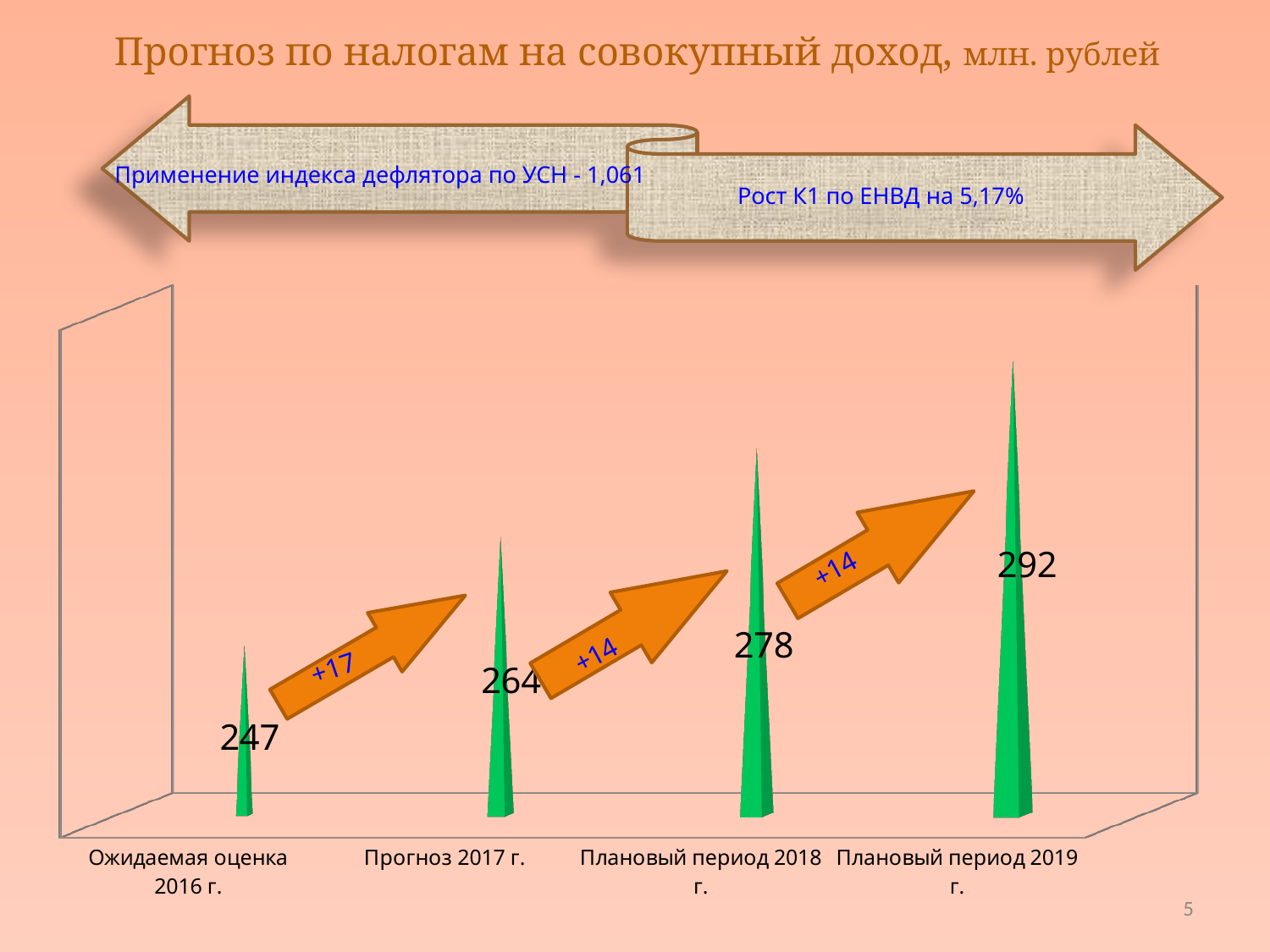
How many categories are shown on the chart? 4 What is the value for Прогноз 2017 г.? 264 What is the title of the slide containing the chart? Прогноз по налогам на совокупный доход, млн. рублей Do the values rise or fall from left to right along the x axis? rise What is the value for Ожидаемая оценка 2016 г.? 247 What is the value for Плановый период 2019 г.? 292 Which is larger, the value for Прогноз 2017 г. or the value for Плановый период 2018 г.? Плановый период 2018 г. Which category has the highest value? Плановый период 2019 г. What is the value for Плановый период 2018 г.? 278 What is the difference between the values for Прогноз 2017 г. and Ожидаемая оценка 2016 г.? 17 Which category has the lowest value? Ожидаемая оценка 2016 г. What is the difference between the values for Плановый период 2019 г. and Ожидаемая оценка 2016 г.? 45